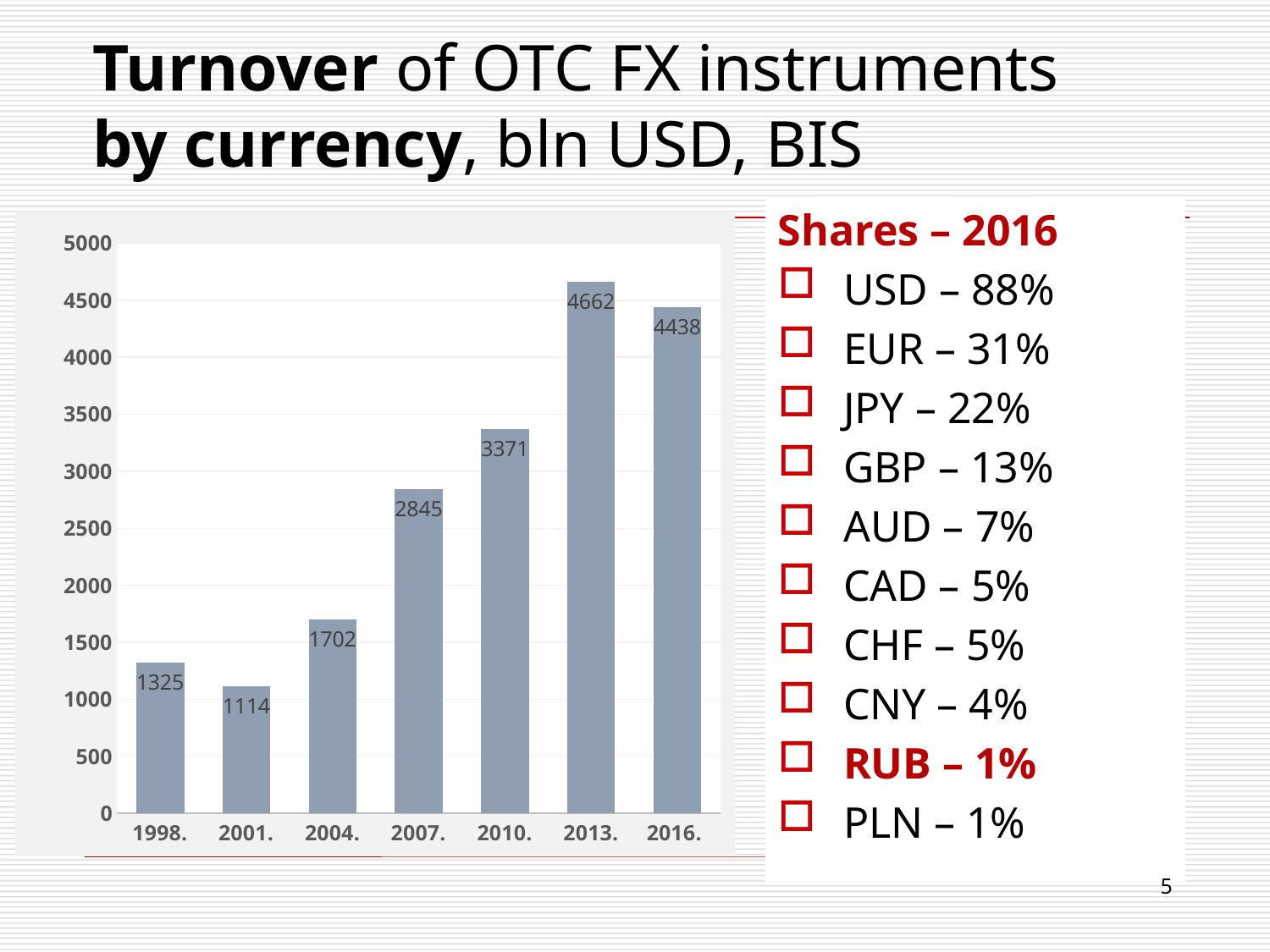
What is the turnover value shown for 2007? 2845 What is the difference between the turnover in 2010 and in 2007? 526 What is the turnover value shown for 2016? 4438 Which year has the lowest turnover in the chart? 2001 What is the turnover value shown for 1998? 1325 How many years are shown on the x axis of the chart? 7 What is the difference between the turnover in 2013 and in 2016? 224 Is the value for 2010 greater or less than 3000? greater What kind of chart is shown on the slide? bar chart Which is larger, the turnover in 2004 or in 1998? 2004 Which year has the highest turnover in the chart? 2013 Does the turnover rise or fall between 2001 and 2013? rise